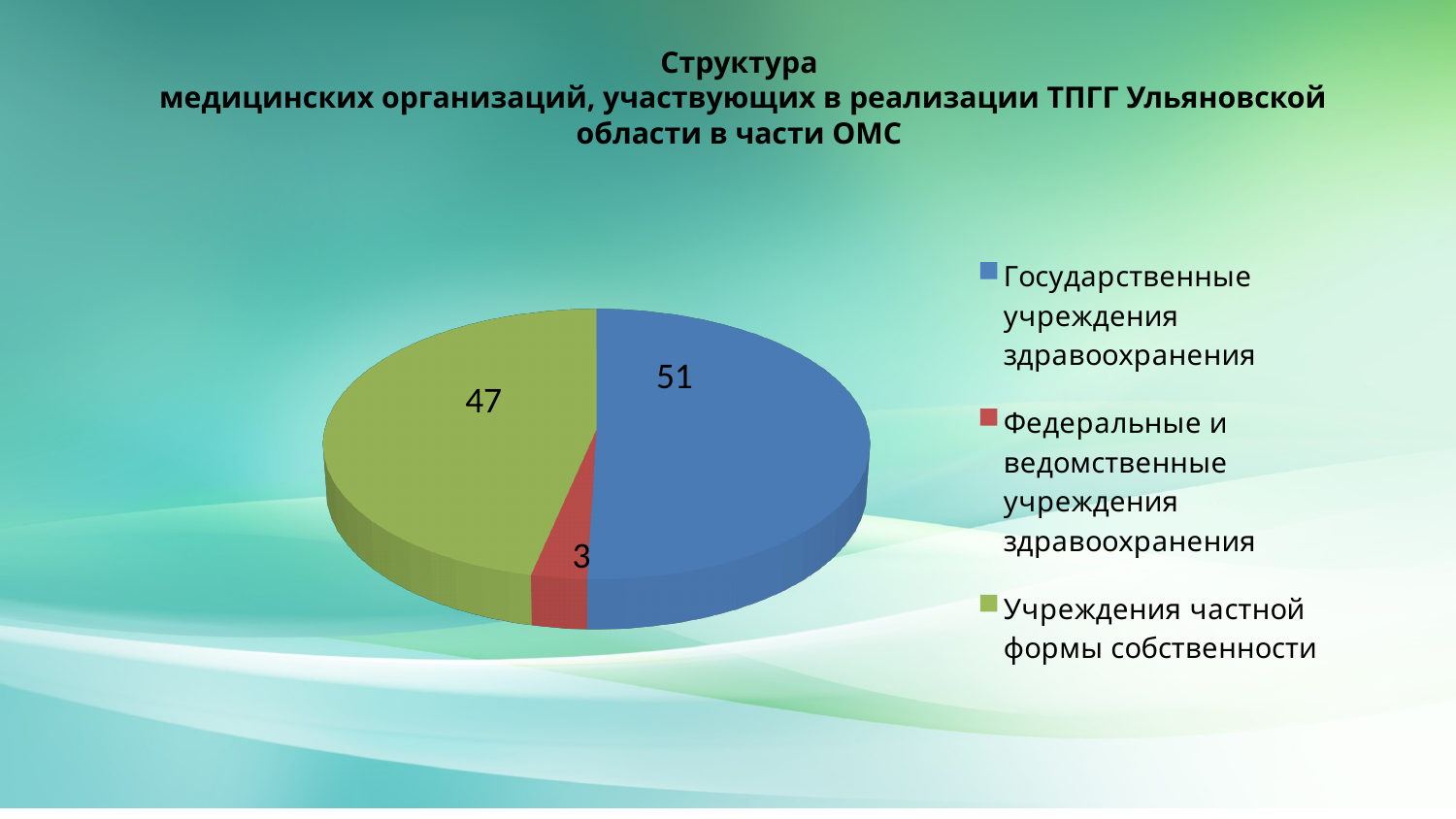
What is the value for Государственные учреждения здравоохранения? 51 What is the value for Федеральные и ведомственные учреждения здравоохранения? 3 What kind of chart is shown on the slide? Pie chart Which category has the smallest slice of the pie? Федеральные и ведомственные учреждения здравоохранения What is the value for Учреждения частной формы собственности? 47 What is the difference between the values for Государственные учреждения здравоохранения and Учреждения частной формы собственности? 4 What is the difference between the values for Учреждения частной формы собственности and Федеральные и ведомственные учреждения здравоохранения? 44 What colour is the slice for Учреждения частной формы собственности? Green How many categories does the pie chart have? 3 Which is larger: the value for Государственные учреждения здравоохранения or the value for Учреждения частной формы собственности? Государственные учреждения здравоохранения What is the total of all the slices in the pie chart? 101 Which category has the largest slice of the pie? Государственные учреждения здравоохранения